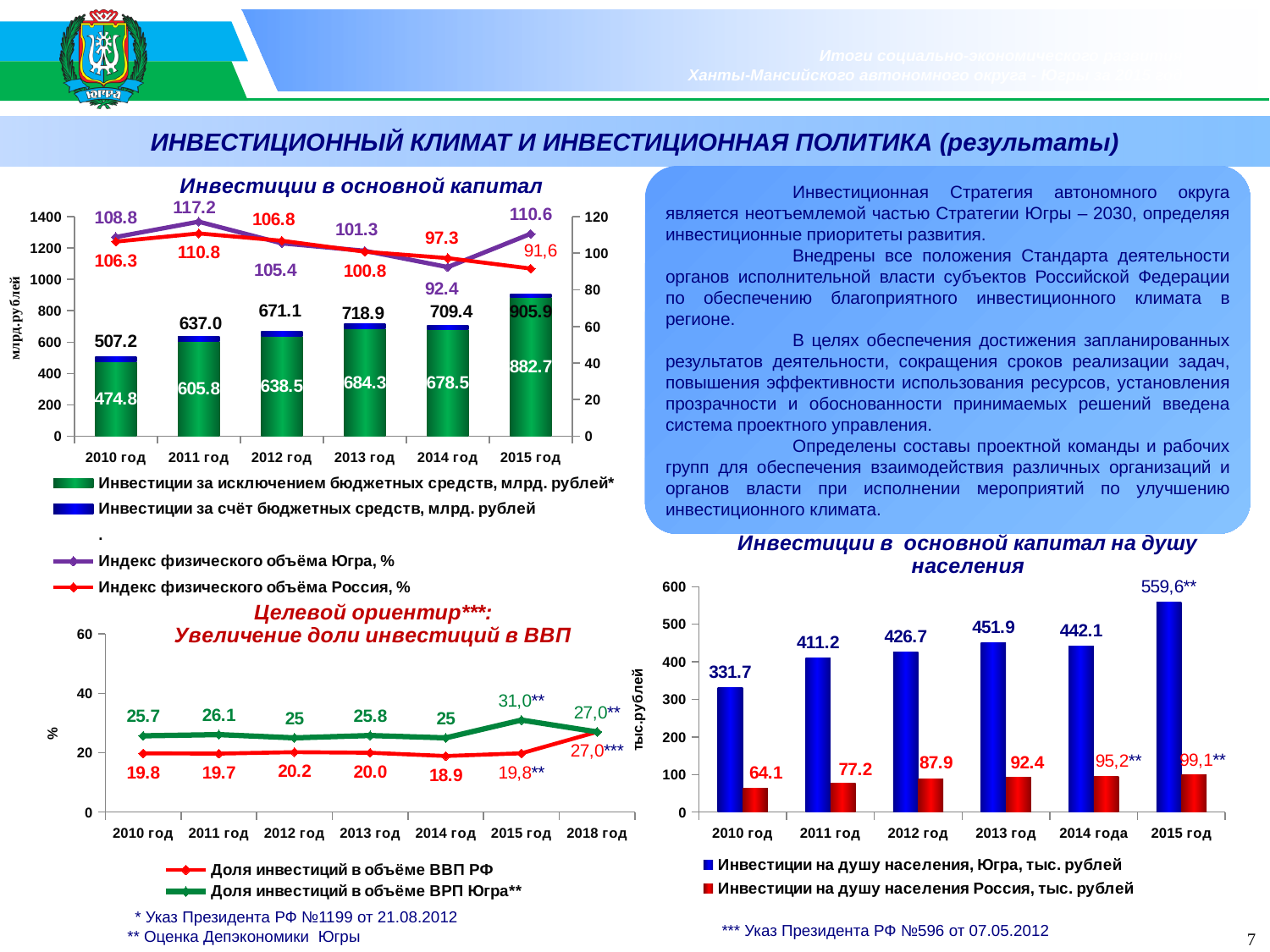
In the chart 'Инвестиции в основной капитал', which year has the lowest total investment? 2010 год In the chart 'Инвестиции в основной капитал', what is the total investment value labeled above the bar for 2015 год? 905.9 In the chart 'Инвестиции в основной капитал', what is the value of 'Инвестиции за исключением бюджетных средств' for 2013 год? 684.3 In the chart 'Целевой ориентир: Увеличение доли инвестиций в ВВП', how many years are shown on the x axis? 7 In the chart 'Целевой ориентир: Увеличение доли инвестиций в ВВП', which is larger in 2014 год: the share for ВВП РФ or the share for ВРП Югра? ВРП Югра In the chart 'Инвестиции в основной капитал на душу населения', what type of chart is used? bar chart In the chart 'Инвестиции в основной капитал', what is the difference between the total investment in 2015 год and in 2014 год? 196.5 In the chart 'Инвестиции в основной капитал на душу населения', what is the value for Югра in 2013 год? 451.9 In the chart 'Инвестиции в основной капитал', how many series does the legend list? 4 In the chart 'Инвестиции в основной капитал', what is the value of 'Индекс физического объёма Югра, %' for 2011 год? 117.2 In the chart 'Инвестиции в основной капитал на душу населения', do the values for Россия rise or fall from 2010 год to 2015 год? rise In the chart 'Целевой ориентир: Увеличение доли инвестиций в ВВП', what is the value of 'Доля инвестиций в объёме ВРП Югра' for 2015 год? 31,0